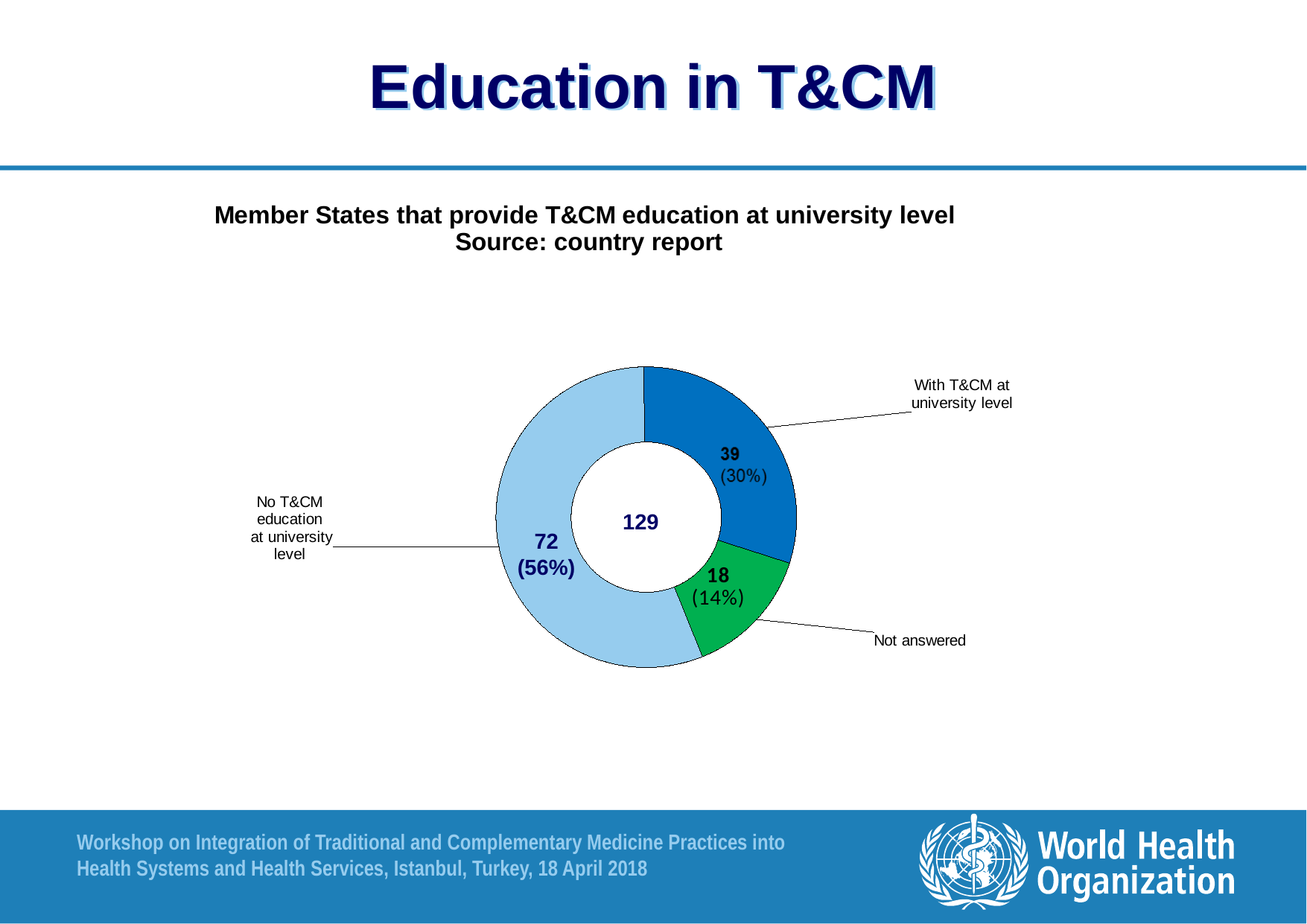
What is the difference between the number of Member States with no T&CM education at university level and those with T&CM at university level? 33 Which category has the smallest slice? Not answered What share of the pie is 'No T&CM education at university level'? 56% What share of the pie is 'With T&CM at university level'? 30% How many Member States have T&CM education at university level? 39 What total number is shown in the centre of the doughnut chart? 129 How many Member States did not answer? 18 Which category has the largest slice? No T&CM education at university level What kind of chart is shown on the slide? Pie chart (doughnut) What share of the pie is 'Not answered'? 14% How many slices does the pie chart have? 3 How many Member States have no T&CM education at university level? 72